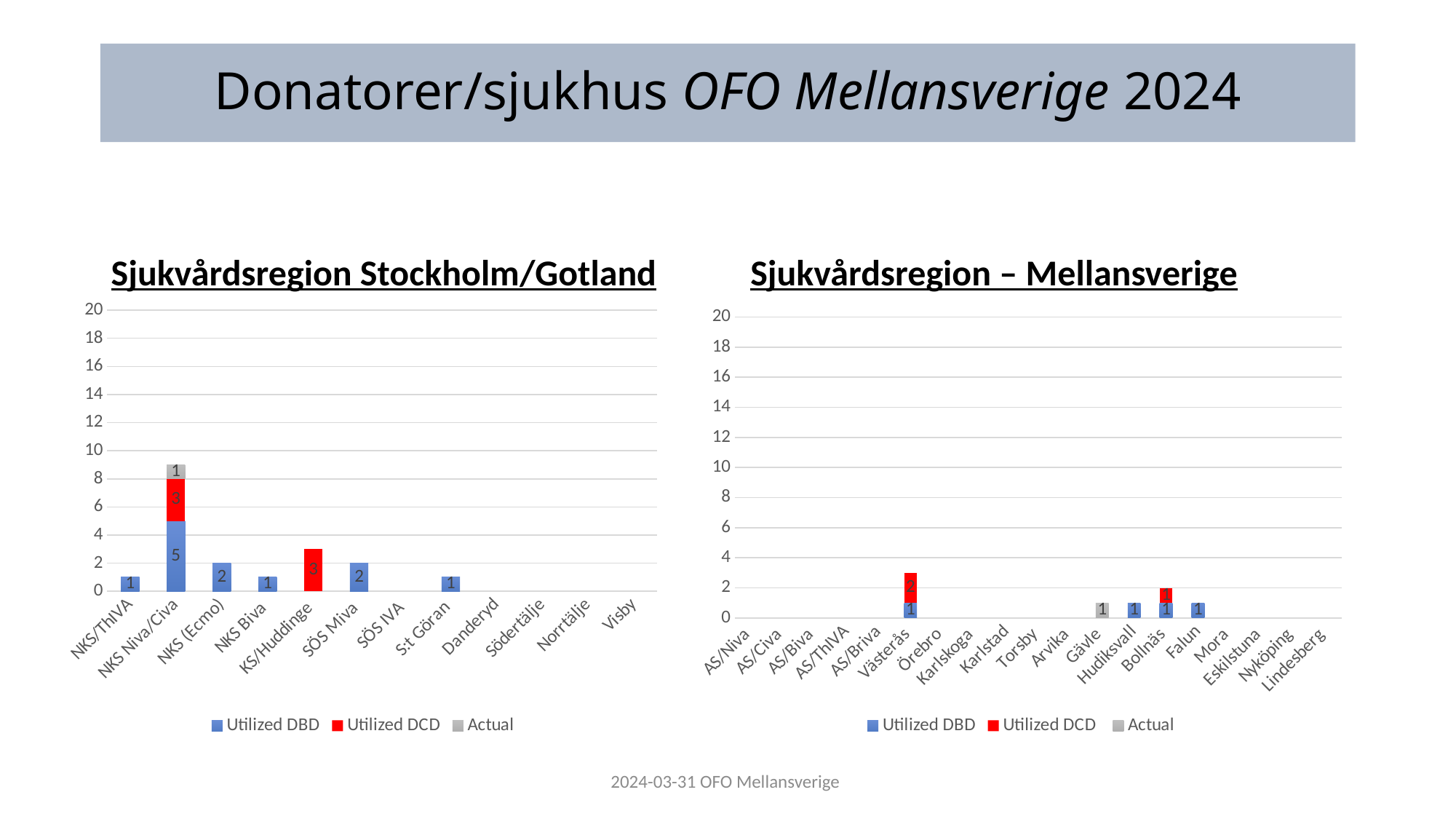
In the Sjukvårdsregion Stockholm/Gotland chart, what is the total height of the stacked bar for NKS Niva/Civa? 9 In the Sjukvårdsregion – Mellansverige chart, which hospital has the highest total bar? Västerås In the Sjukvårdsregion Stockholm/Gotland chart, what is the difference between the Utilized DBD values for NKS Niva/Civa and NKS (Ecmo)? 3 In the Sjukvårdsregion – Mellansverige chart, which series does the Gävle bar belong to? Actual In the Sjukvårdsregion – Mellansverige chart, what is the total height of the stacked bar for Bollnäs? 2 How many hospital categories are shown on the x axis of the Sjukvårdsregion Stockholm/Gotland chart? 12 In the Sjukvårdsregion – Mellansverige chart, what is the Utilized DCD value for Västerås? 2 In the Sjukvårdsregion Stockholm/Gotland chart, which hospital has the highest total bar? NKS Niva/Civa How many series does the legend of the Sjukvårdsregion Stockholm/Gotland chart list? 3 In the Sjukvårdsregion Stockholm/Gotland chart, what is the Utilized DBD value for NKS Niva/Civa? 5 In the Sjukvårdsregion Stockholm/Gotland chart, what is the Utilized DCD value for KS/Huddinge? 3 What kind of chart is the Sjukvårdsregion – Mellansverige chart? Stacked bar chart